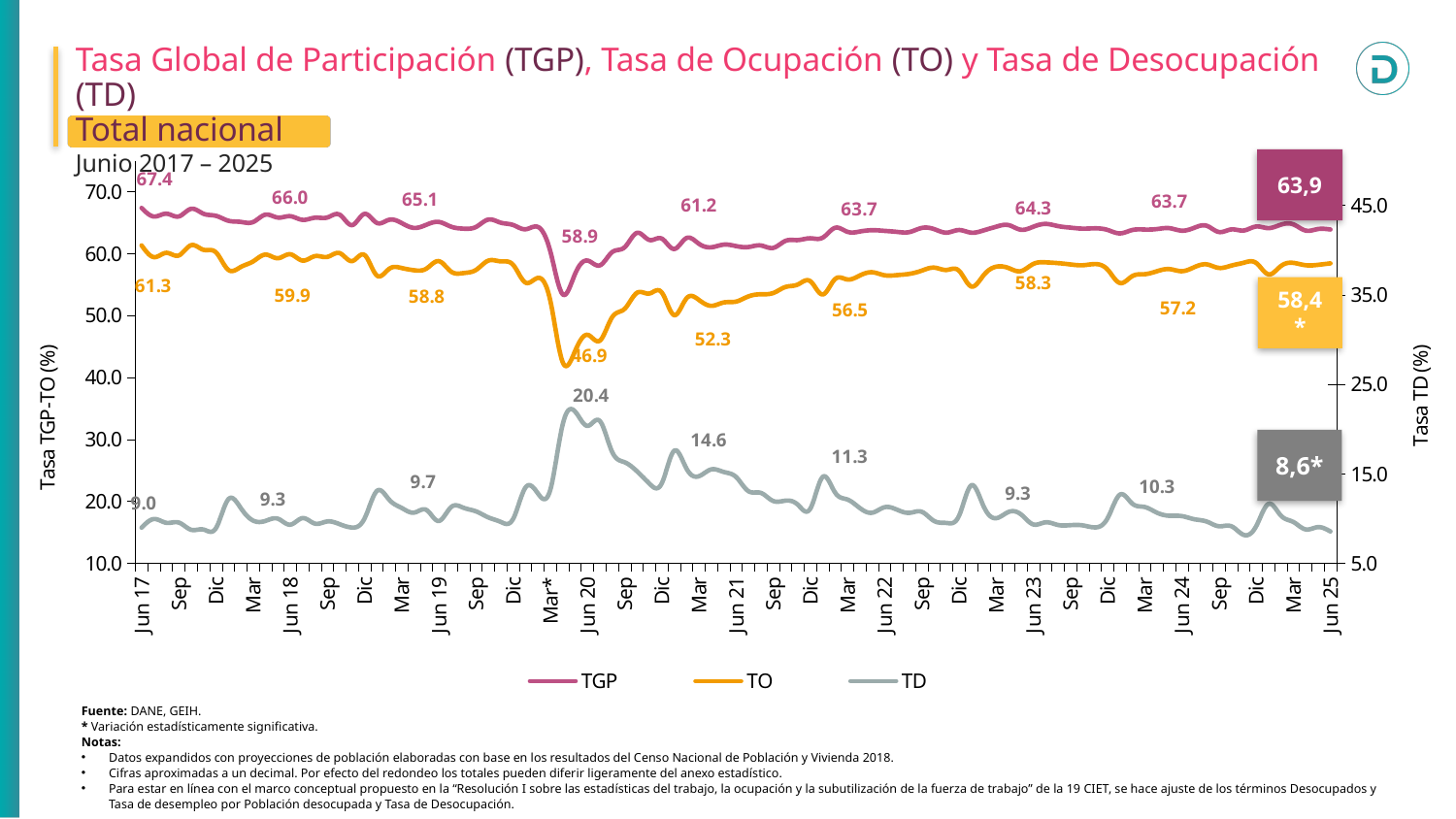
What is the difference between the labelled TGP values for Jun 17 and Jun 20? 8.5 What is the TGP value labelled for Jun 25? 63,9 What is the TO value labelled for Jun 20? 46.9 Among the labelled TD values, which date has the highest value? Jun 20 What is the TD value labelled for Jun 25? 8,6* What is the difference between the labelled TD values for Jun 20 and Jun 21? 5.8 Which series is drawn in orange? TO What type of chart is shown on the slide? line chart How many series does the legend list? 3 Among the labelled TO values, which date has the lowest value? Jun 20 Which is larger, the labelled TD value for Jun 21 or for Jun 22? Jun 21 What is the TGP value labelled for Jun 17? 67.4